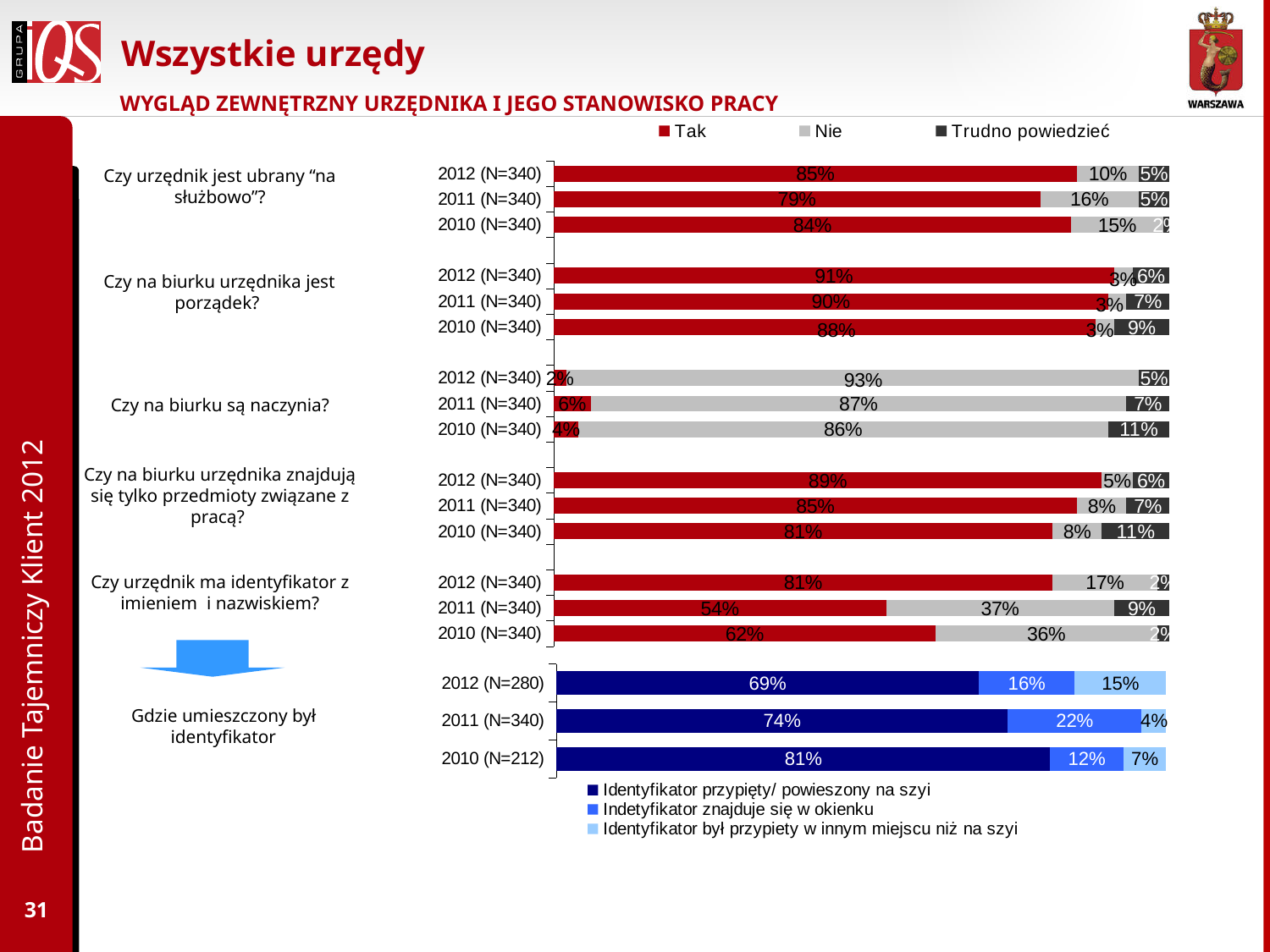
In the upper chart, for "Czy urzędnik ma identyfikator z imieniem i nazwiskiem?", which year has the lowest "Tak" value? 2011 (N=340) In the upper chart, what is the difference between the "Tak" values for "Czy urzędnik ma identyfikator z imieniem i nazwiskiem?" in 2012 and 2011? 27 percentage points In the upper chart, what is the "Nie" value for "Czy urzędnik ma identyfikator z imieniem i nazwiskiem?" in 2011 (N=340)? 37% In the lower chart ("Gdzie umieszczony był identyfikator"), what is the value for "Identyfikator przypięty/ powieszony na szyi" in 2012 (N=280)? 69% In the upper chart, what is the "Tak" value for "Czy na biurku urzędnika jest porządek?" in 2010 (N=340)? 88% What kind of chart is the lower chart ("Gdzie umieszczony był identyfikator")? Stacked horizontal bar chart In the lower chart ("Gdzie umieszczony był identyfikator"), how does the "Identyfikator przypięty/ powieszony na szyi" value change from 2010 to 2012? It falls (81% to 74% to 69%) In the lower chart ("Gdzie umieszczony był identyfikator"), what is the value for "Indetyfikator znajduje się w okienku" in 2011 (N=340)? 22% In the upper chart, what percentage answered "Tak" to "Czy urzędnik jest ubrany na służbowo?" in 2012 (N=340)? 85% In the upper chart, for "Czy urzędnik ma identyfikator z imieniem i nazwiskiem?", which year has the highest "Tak" value? 2012 (N=340) In the upper chart, which is larger: the "Nie" value for "Czy na biurku są naczynia?" in 2012 or in 2011? 2012 How many series does the legend of the upper chart list? 3